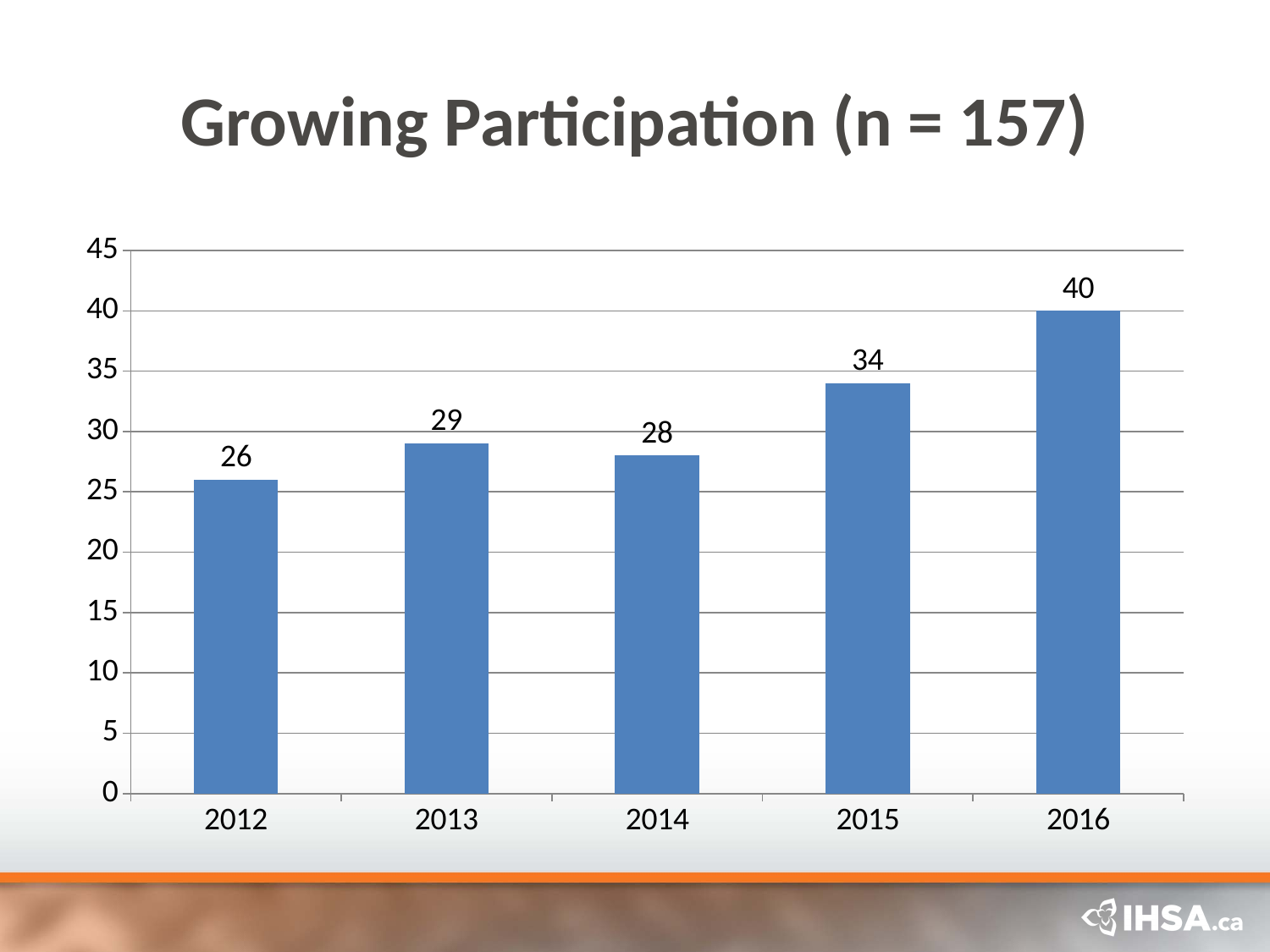
Which year has the highest value? 2016 What is the value for 2015? 34 What is the value for 2014? 28 What is the value for 2012? 26 What kind of chart is shown on the slide? bar chart Is the value for 2016 greater or less than 35? greater What is the difference between the values for 2016 and 2012? 14 What is the difference between the values for 2013 and 2014? 1 Which is larger, the value for 2015 or the value for 2013? 2015 Which year has the lowest value? 2012 How many years are shown on the x axis? 5 What is the title of the chart on the slide? Growing Participation (n = 157)